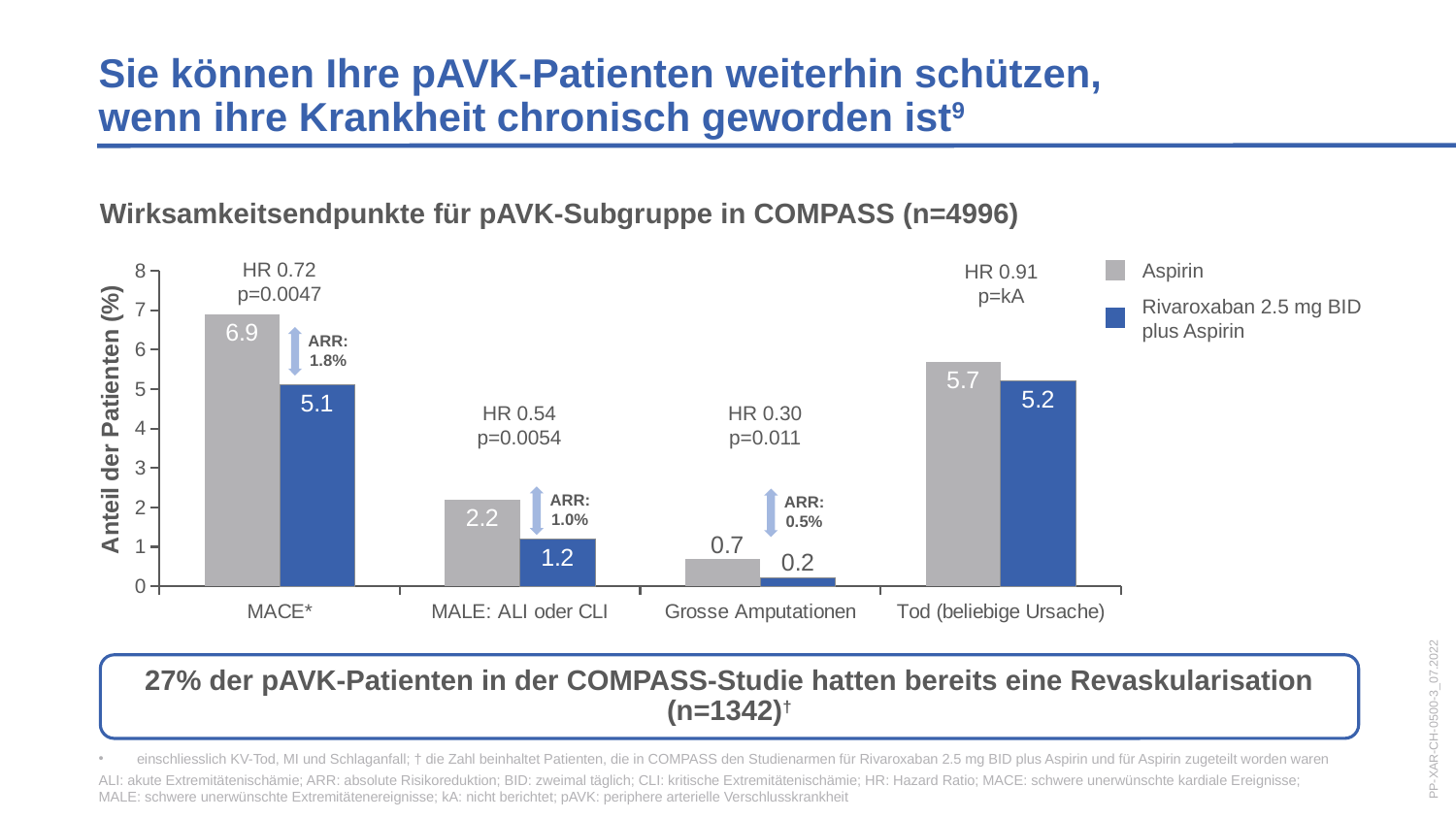
Which is larger in the Tod (beliebige Ursache) category: the Aspirin value or the Rivaroxaban 2.5 mg BID plus Aspirin value? Aspirin What is the value for Rivaroxaban 2.5 mg BID plus Aspirin in the Grosse Amputationen category? 0.2 Which category has the highest value for Aspirin? MACE* Which category has the lowest value for Rivaroxaban 2.5 mg BID plus Aspirin? Grosse Amputationen What is the difference between the Aspirin and Rivaroxaban 2.5 mg BID plus Aspirin values in the MALE: ALI oder CLI category? 1.0 What is the value for Aspirin in the MACE* category? 6.9 What kind of chart is shown on the slide? bar chart How many series does the legend list? 2 How many categories are shown on the x axis of the chart? 4 What is the label of the y axis of the chart? Anteil der Patienten (%) Is the Aspirin value for MACE* greater or less than 6? greater What is the value for Rivaroxaban 2.5 mg BID plus Aspirin in the Tod (beliebige Ursache) category? 5.2